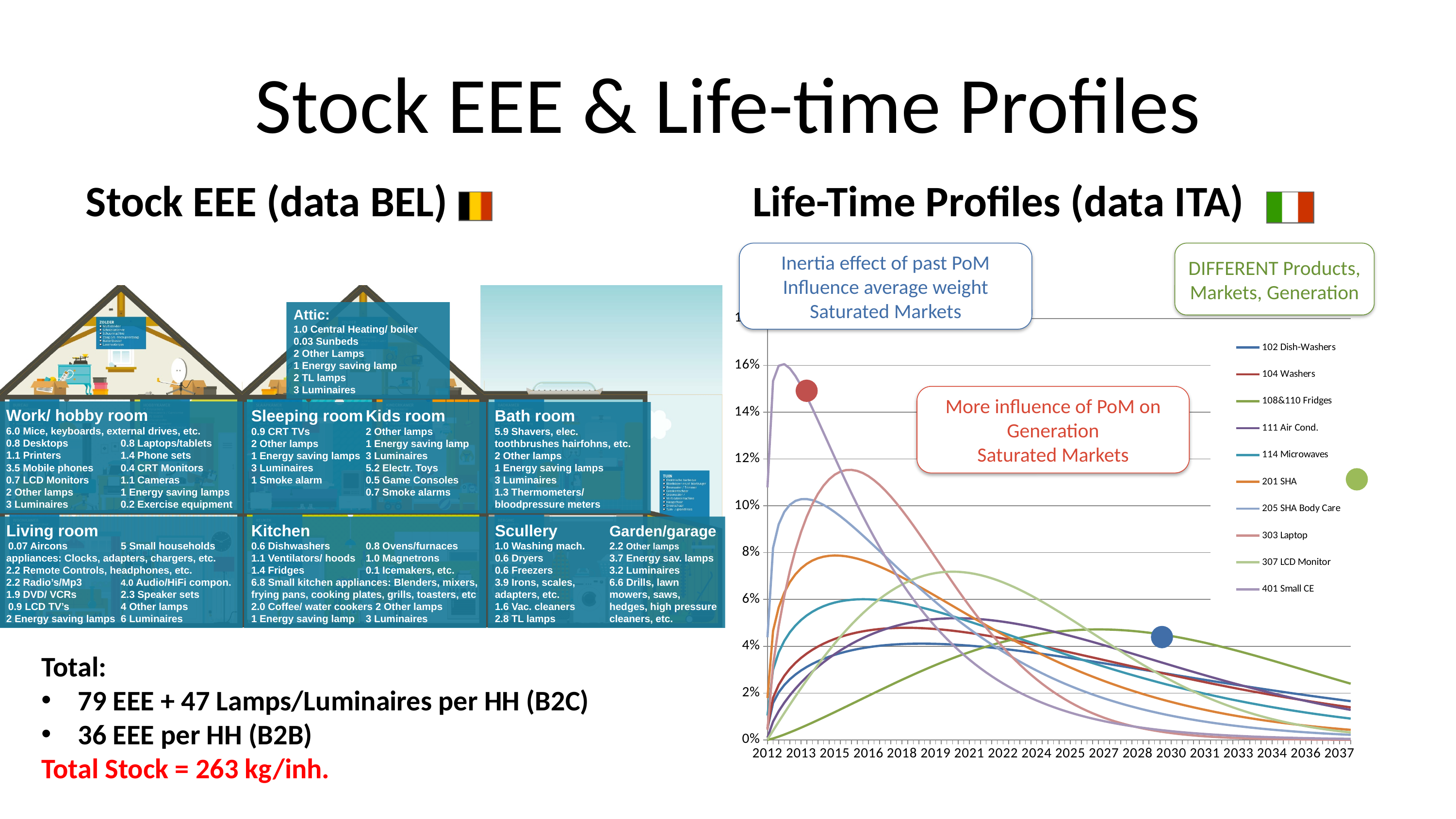
In the Life-Time Profiles chart, which series has the higher peak, 401 Small CE or 303 Laptop? 401 Small CE What kind of chart is the Life-Time Profiles (data ITA) chart? line chart In the Life-Time Profiles chart, is the peak value of 401 Small CE greater or less than 14%? greater In the Life-Time Profiles chart, does the 401 Small CE line rise or fall from 2013 to 2037? fall In the Life-Time Profiles chart, does the 108&110 Fridges line rise or fall from 2012 to 2027? rise In the Life-Time Profiles chart, which series is drawn in orange? 201 SHA In the Life-Time Profiles chart, is the peak value of 307 LCD Monitor greater or less than 6%? greater How many series does the legend of the Life-Time Profiles chart list? 10 In the Life-Time Profiles chart, which series reaches the highest peak value? 401 Small CE In the Life-Time Profiles chart, is the peak value of 303 Laptop greater or less than 10%? greater What is the first year label on the x axis of the Life-Time Profiles chart? 2012